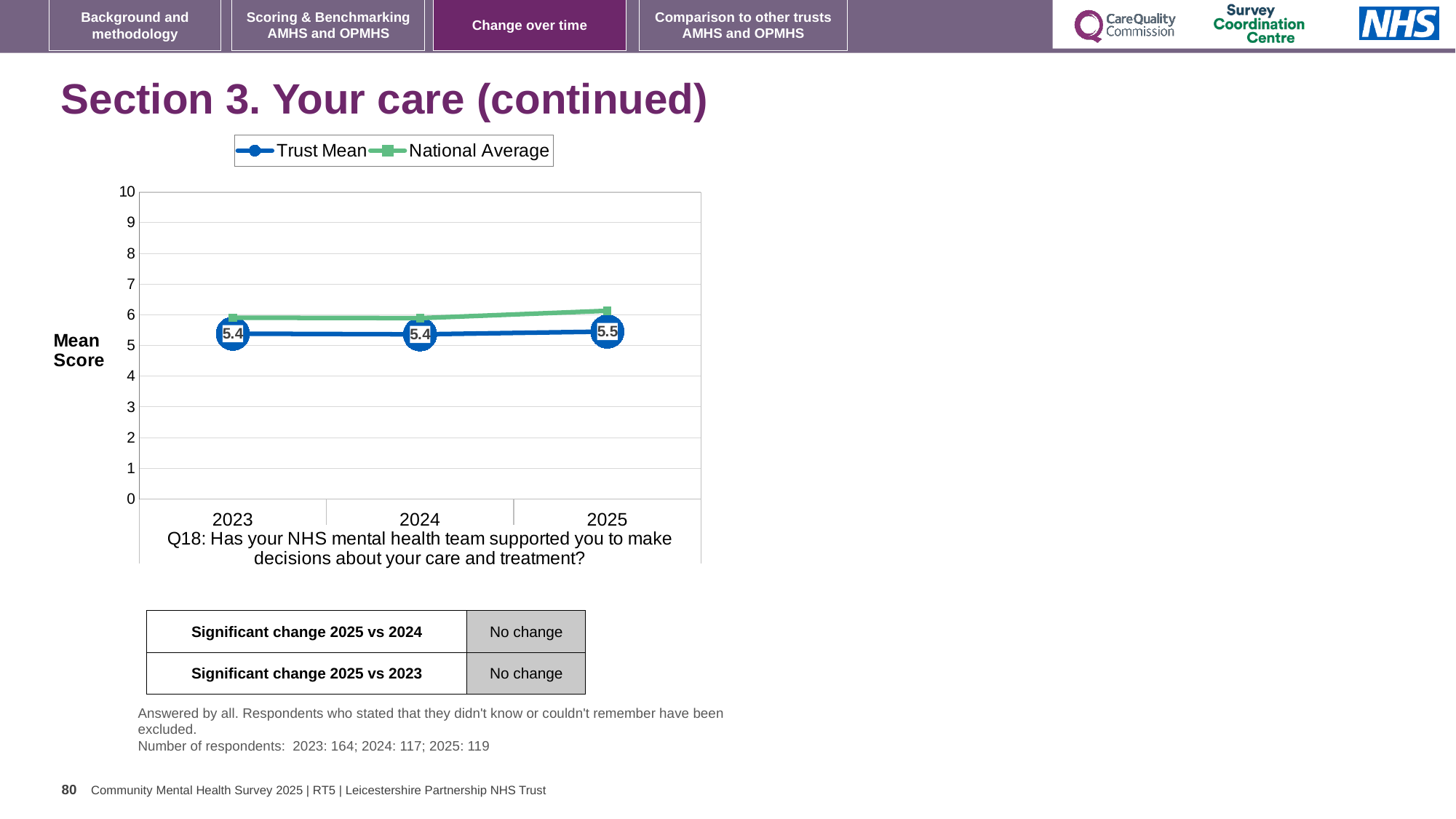
Is the National Average value for 2025 greater or less than 5? greater What is the difference between the Trust Mean in 2025 and in 2023? 0.1 In 2025, which is higher: the Trust Mean or the National Average? National Average What is the label on the y axis of the chart? Mean Score In which year is the Trust Mean highest? 2025 What is the Trust Mean score for 2023? 5.4 What is the Trust Mean score for 2024? 5.4 How many years are plotted on the x axis? 3 What kind of chart is shown on the slide? Line chart Is the National Average value for 2023 greater or less than 7? less How many series does the legend list? 2 What is the Trust Mean score for 2025? 5.5